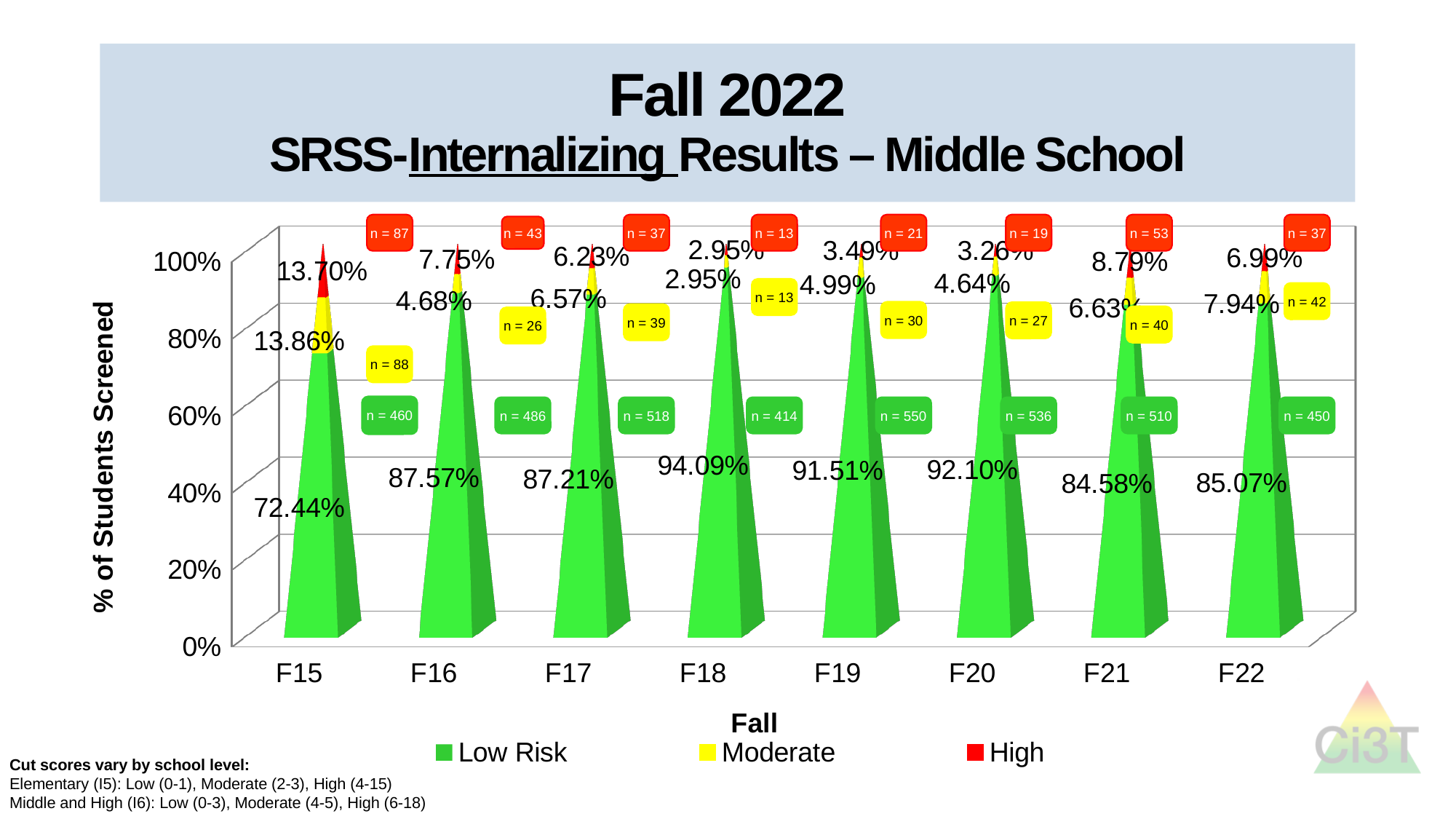
What percentage of students were in the High category in F21? 8.79% How many fall semesters are shown on the x axis? 8 What kind of chart is shown on the slide? Stacked bar chart Which fall has the highest Low Risk percentage? F18 What percentage of students were Low Risk in F18? 94.09% Which is larger, the Low Risk percentage in F19 or in F21? F19 What colour represents the Moderate category in the legend? Yellow What percentage of students were Low Risk in F15? 72.44% What is the difference between the Low Risk percentage in F16 and in F15? 15.13% What percentage of students were in the Moderate category in F22? 7.94% Which fall has the lowest Low Risk percentage? F15 How many series does the legend list? 3